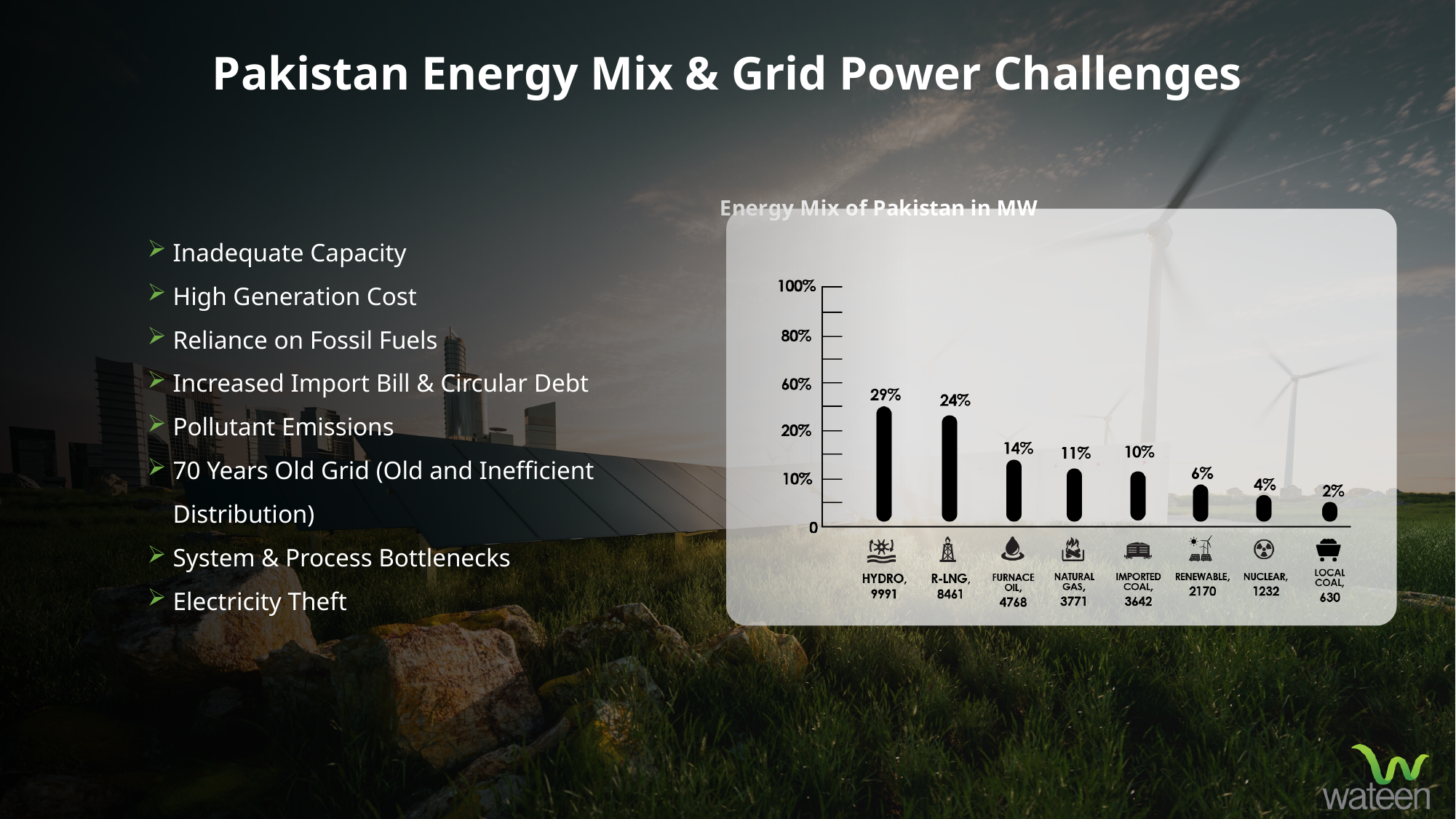
How many energy sources are shown in the Energy Mix of Pakistan chart? 8 What is the MW value shown for R-LNG in the Energy Mix of Pakistan chart? 8461 Which energy source has the highest share in the Energy Mix of Pakistan chart? Hydro Which has a larger share in the Energy Mix of Pakistan chart, Furnace Oil or Imported Coal? Furnace Oil What kind of chart is the Energy Mix of Pakistan chart? Bar chart What is the title of the chart on the slide? Energy Mix of Pakistan in MW What percentage share does Hydro have in the Energy Mix of Pakistan chart? 29% Which energy source has the lowest share in the Energy Mix of Pakistan chart? Local Coal What is the MW value shown for Nuclear in the Energy Mix of Pakistan chart? 1232 What is the difference in percentage points between Hydro and R-LNG in the Energy Mix of Pakistan chart? 5% What percentage is shown for Natural Gas in the Energy Mix of Pakistan chart? 11% Do the values in the Energy Mix of Pakistan chart rise or fall from left to right? Fall